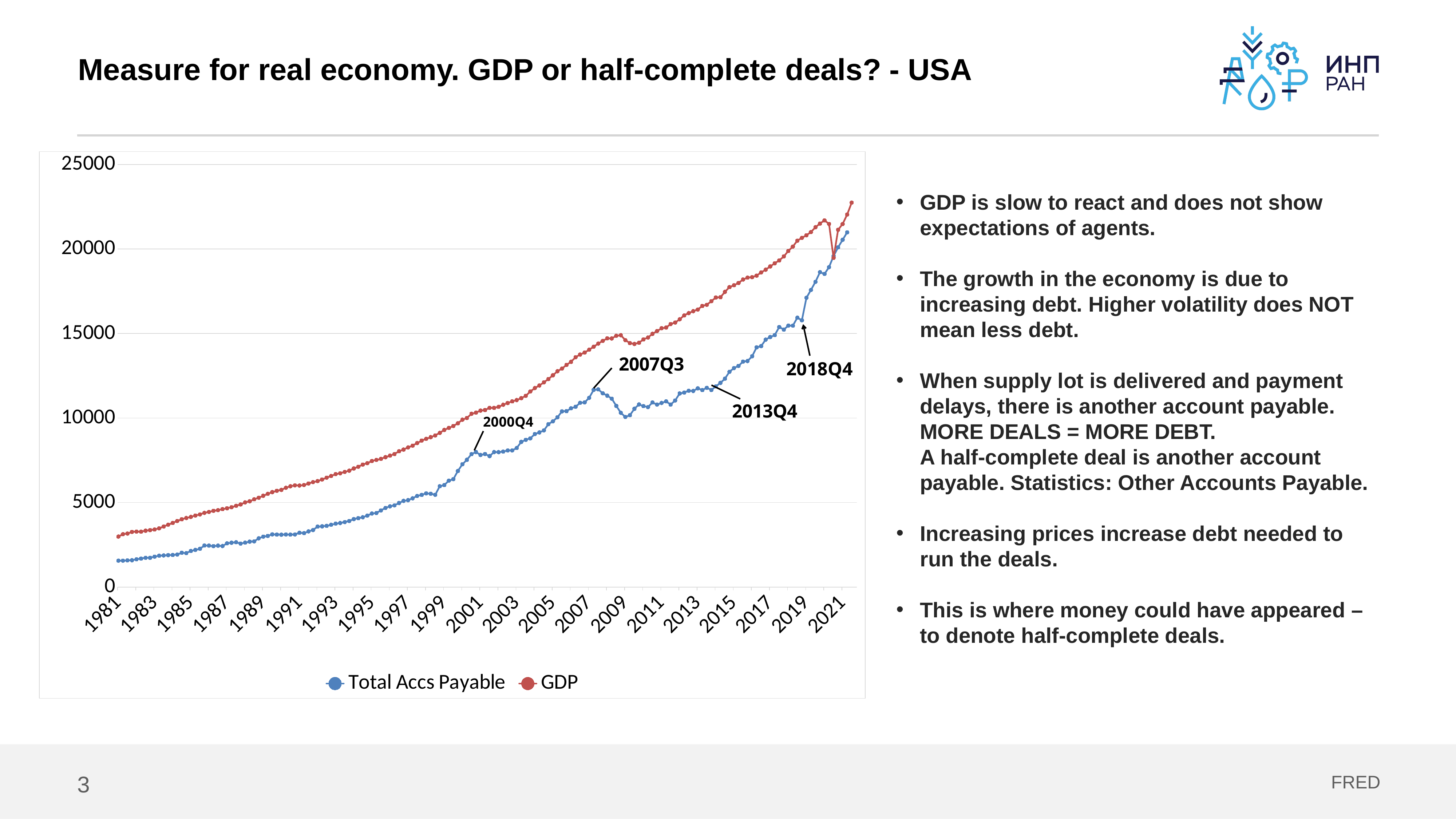
How many year labels are shown on the x axis? 21 Is the value of Total Accs Payable in 2001 greater or less than 10000? less How many series does the legend list? 2 Is the value of Total Accs Payable in 1981 greater or less than 5000? less In 2011, which series has the higher value, GDP or Total Accs Payable? GDP Is the value of GDP in 1991 greater or less than 5000? greater What kind of chart is shown on the slide? line chart Which series is drawn in red? GDP Which two series are listed in the chart legend? Total Accs Payable and GDP Does the GDP series generally rise or fall from 1981 to 2021? rise